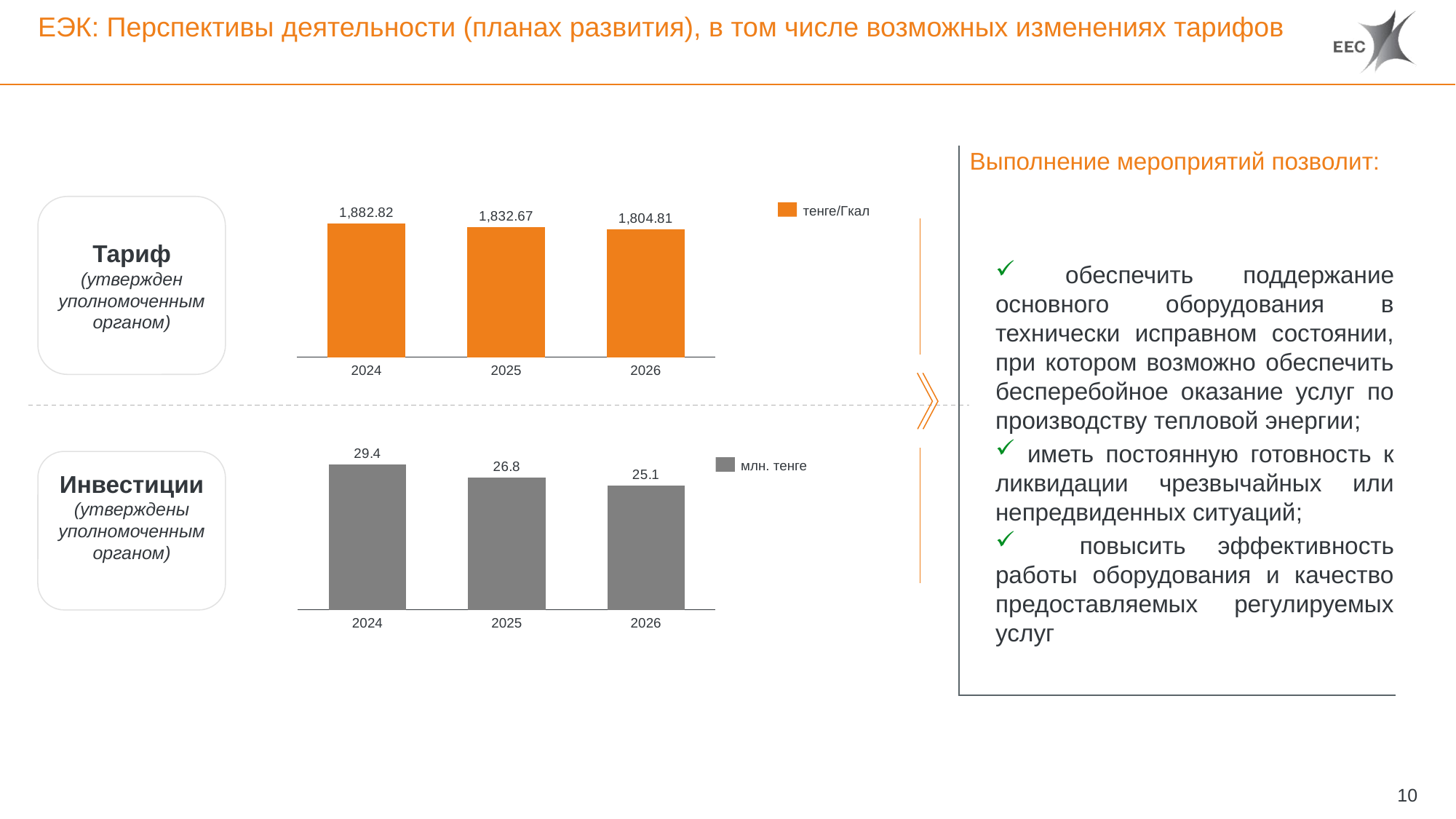
What unit does the legend of the bottom chart (Инвестиции) show? млн. тенге In the bottom chart (Инвестиции), which is larger: the value for 2025 or the value for 2026? 2025 In the bottom chart (Инвестиции), what is the difference between the 2024 and 2026 values? 4.3 How many years are shown on the x axis of the top chart (Тариф)? 3 What type of chart is the bottom chart (Инвестиции)? Bar chart In the top chart (Тариф), what is the difference between the 2024 and 2025 values? 50.15 In the bottom chart (Инвестиции), which year has the highest value? 2024 In the top chart (Тариф), which year has the lowest value? 2026 In the bottom chart (Инвестиции), what is the value for 2025? 26.8 In the top chart (Тариф), what is the value for 2024? 1,882.82 In the top chart (Тариф), what is the value for 2026? 1,804.81 In the top chart (Тариф), do the values rise or fall from 2024 to 2026? Fall